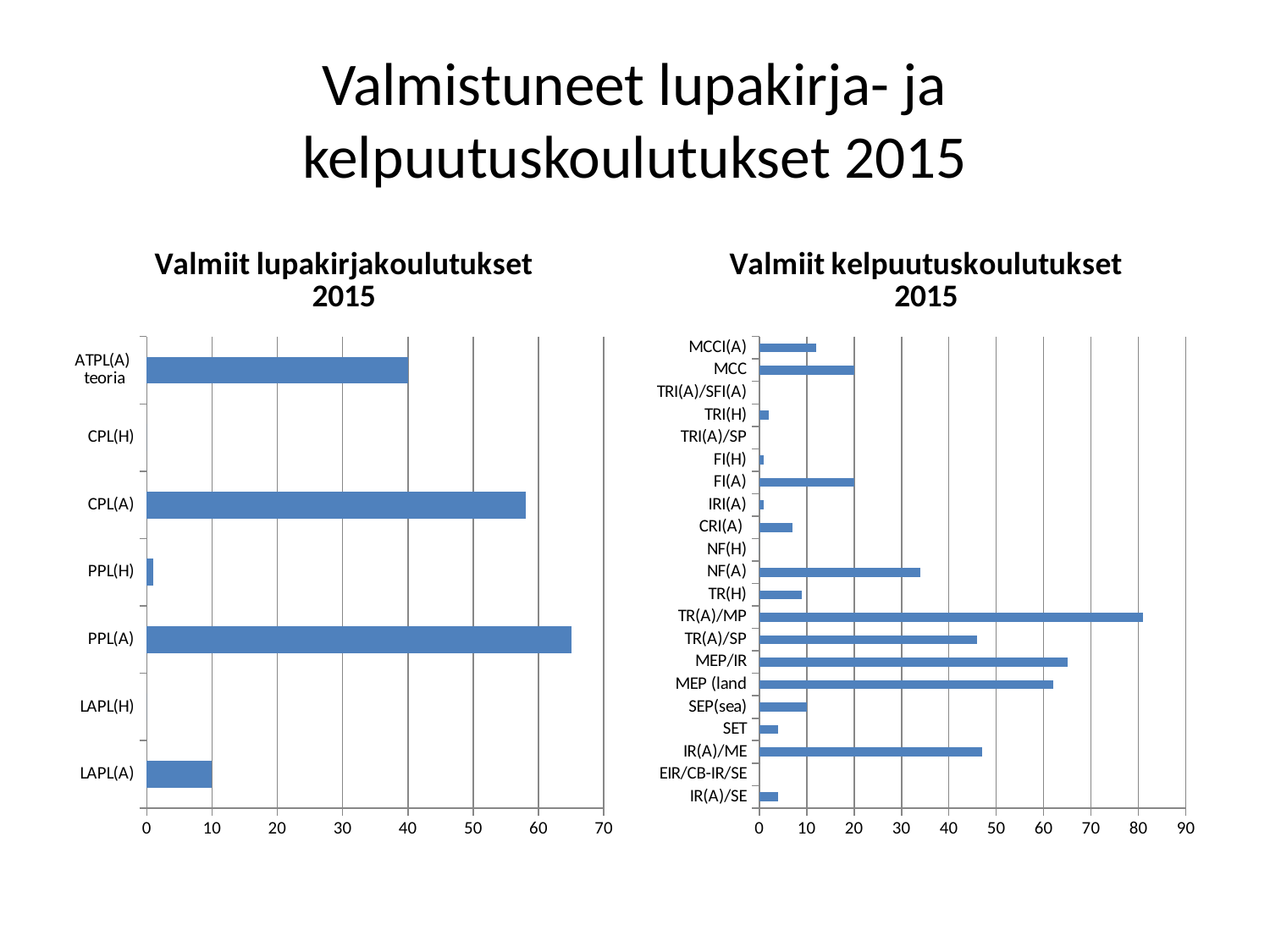
How many categories are shown in the chart "Valmiit kelpuutuskoulutukset 2015"? 21 In the chart "Valmiit lupakirjakoulutukset 2015", which is larger, ATPL(A) teoria or CPL(A)? CPL(A) In the chart "Valmiit lupakirjakoulutukset 2015", which category has the highest value? PPL(A) In the chart "Valmiit kelpuutuskoulutukset 2015", which is larger, MEP/IR or IR(A)/ME? MEP/IR What is the maximum value shown on the x axis of the chart "Valmiit kelpuutuskoulutukset 2015"? 90 In the chart "Valmiit lupakirjakoulutukset 2015", what is the value for LAPL(A)? 10 How many categories are shown in the chart "Valmiit lupakirjakoulutukset 2015"? 7 What kind of chart is "Valmiit lupakirjakoulutukset 2015"? bar chart In the chart "Valmiit lupakirjakoulutukset 2015", is the value for CPL(A) greater or less than 50? greater In the chart "Valmiit kelpuutuskoulutukset 2015", is the value for NF(A) greater or less than 30? greater In the chart "Valmiit kelpuutuskoulutukset 2015", which category has the highest value? TR(A)/MP